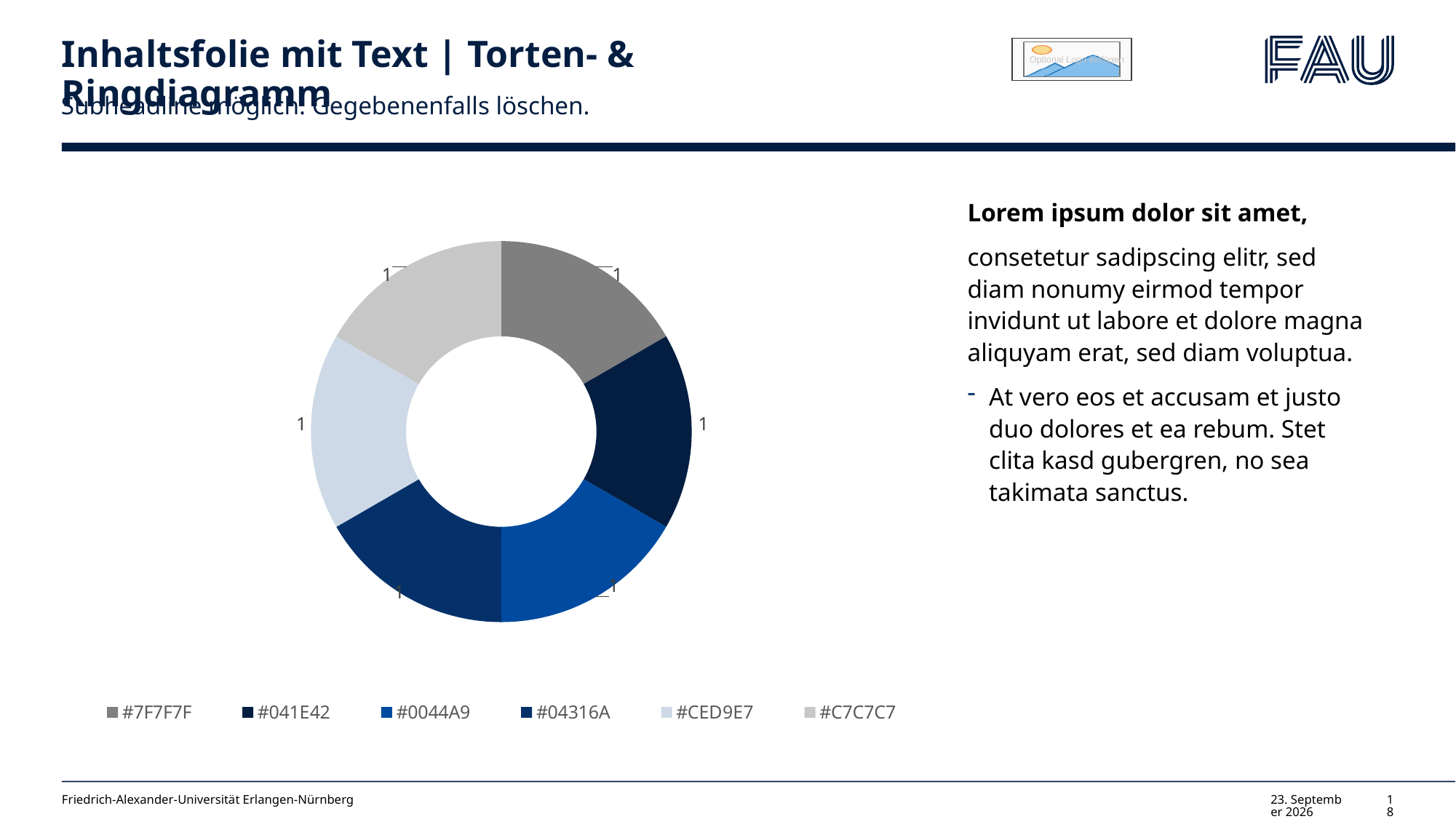
What is the total of all slice values in the doughnut chart? 6 What is the value of the slice for #CED9E7? 1 What is the first entry listed in the legend? #7F7F7F What is the difference between the values for #041E42 and #0044A9? 0 Do the slices for #0044A9 and #C7C7C7 have the same value? yes What is the value of the slice for #7F7F7F? 1 How many slices does the doughnut chart have? 6 What is the value of the slice for #04316A? 1 What kind of chart is shown on the slide? doughnut chart How many entries does the legend list? 6